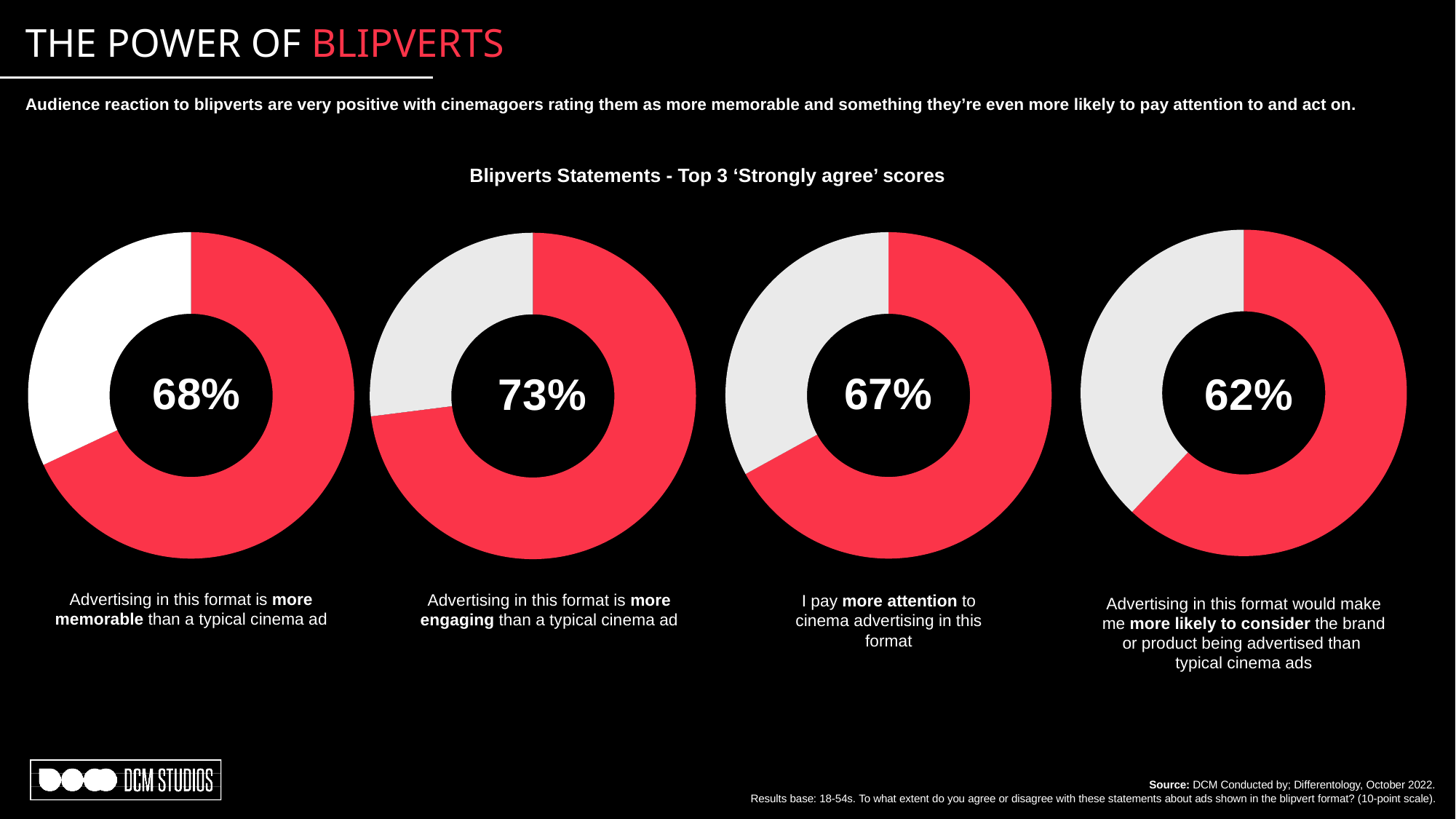
What percentage strongly agree that advertising in this format is more memorable than a typical cinema ad? 68% Which is larger: the 'more memorable' score or the 'more likely to consider' score? More memorable (68%) What percentage strongly agree that advertising in this format is more engaging than a typical cinema ad? 73% Which statement has the highest 'Strongly agree' score? Advertising in this format is more engaging than a typical cinema ad How many donut charts are shown on the slide? 4 What percentage strongly agree with 'I pay more attention to cinema advertising in this format'? 67% What kind of chart is used to show the 'Strongly agree' scores? Donut (pie) chart What percentage strongly agree that advertising in this format would make them more likely to consider the brand or product being advertised? 62% What is the difference between the 'more engaging' score and the 'more likely to consider' score? 11 percentage points Which statement has the lowest 'Strongly agree' score? Advertising in this format would make me more likely to consider the brand or product being advertised than typical cinema ads What is the title of the chart section on the slide? Blipverts Statements - Top 3 'Strongly agree' scores What is the difference between the 'more memorable' score and the 'more attention' score? 1 percentage point